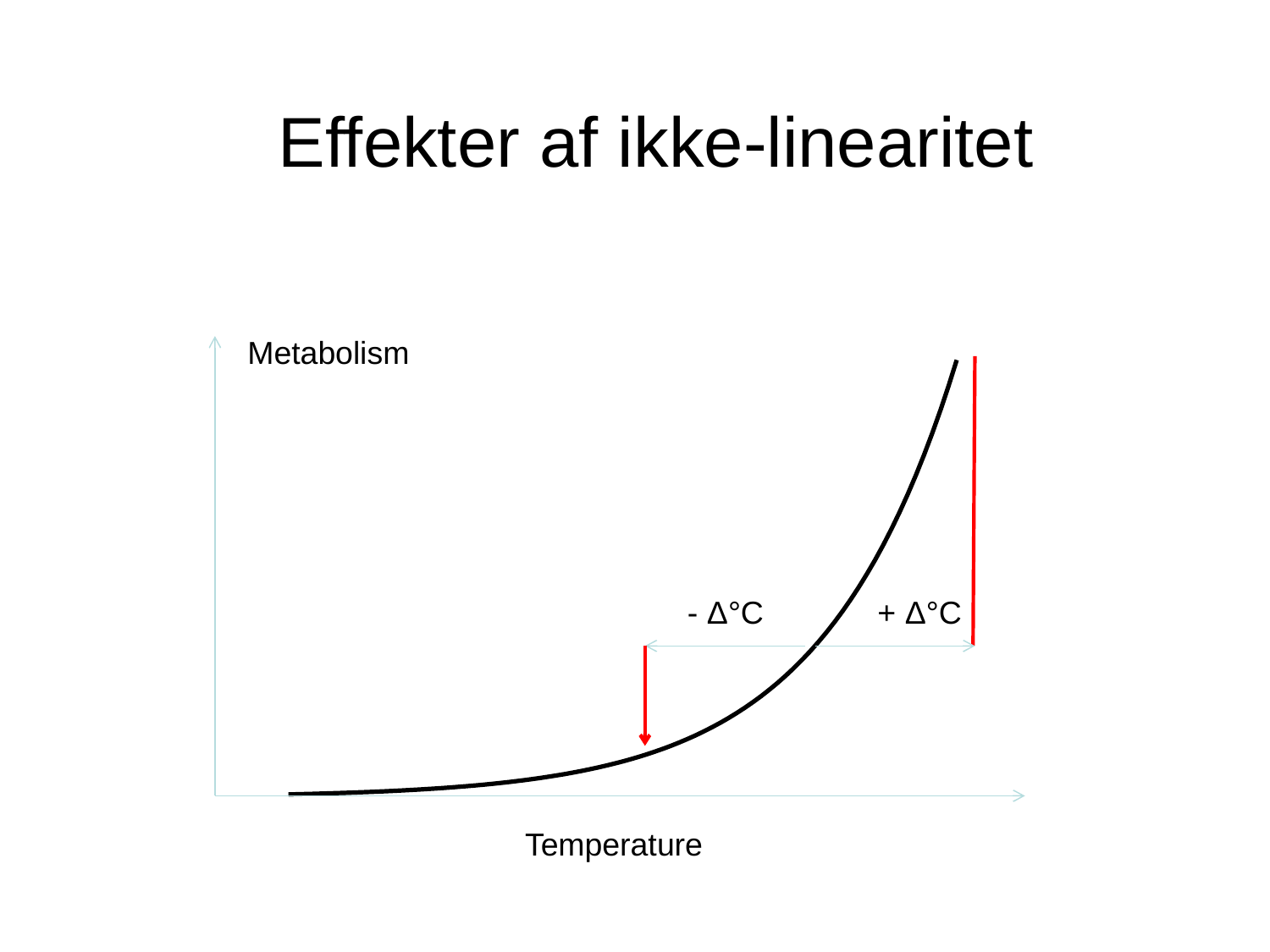
How many curves are plotted on the chart? 1 Does the metabolism curve rise or fall as temperature increases along the x axis? rise What is the label of the horizontal axis? Temperature What is the label of the vertical axis? Metabolism Is the change in metabolism for - Δ°C larger or smaller than the change for + Δ°C? smaller What kind of chart is shown on the slide? line chart Which produces the larger change in metabolism, the temperature decrease (- Δ°C) or the temperature increase (+ Δ°C)? + Δ°C